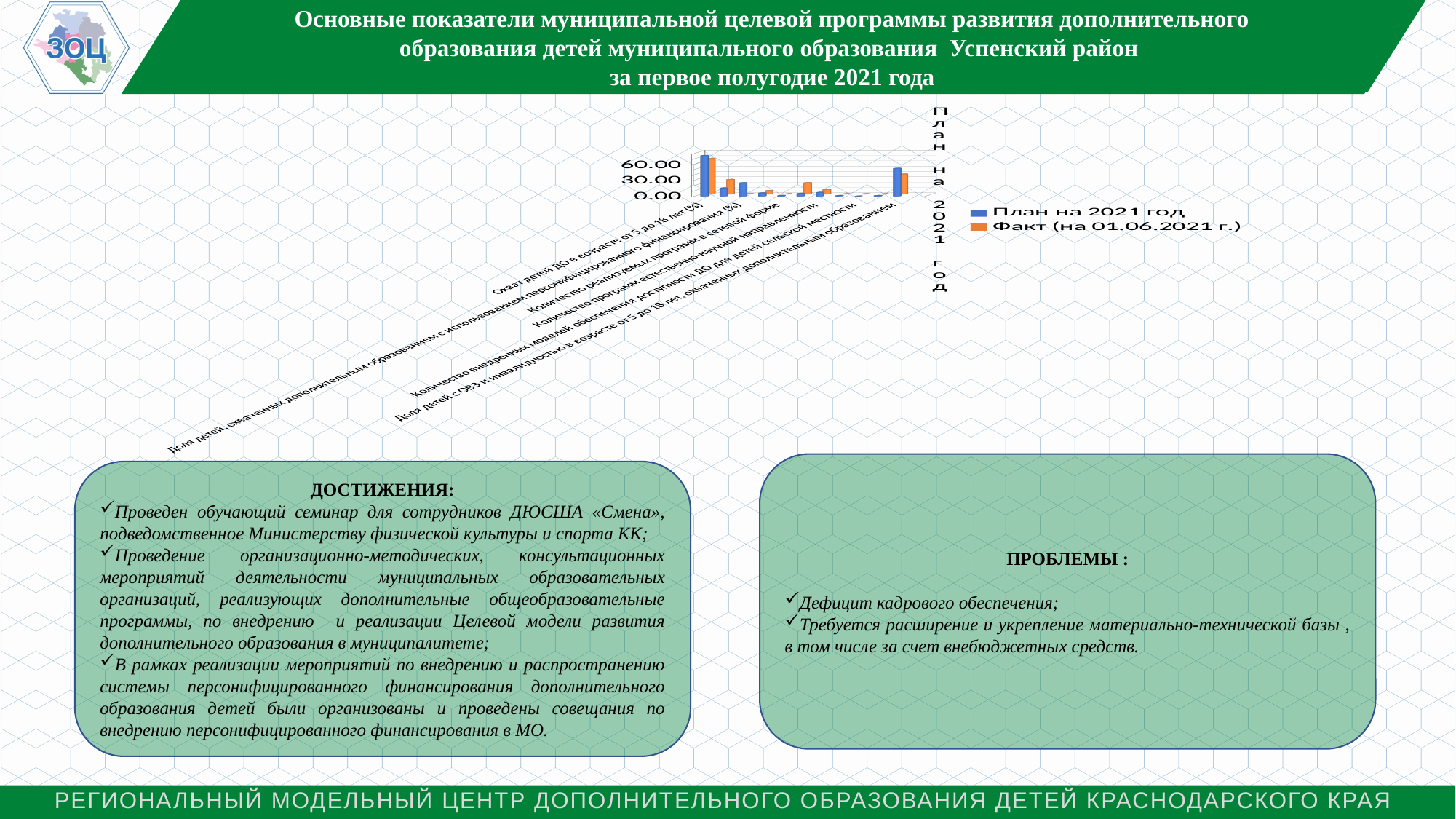
What kind of chart is shown on the slide? Bar chart How many series does the chart legend list? 2 Is the 'Факт (на 01.06.2021 г.)' value for 'Доля детей с ОВЗ и инвалидностью в возрасте от 5 до 18 лет, охваченных дополнительным образованием' greater or less than 30? greater What colour represents the series 'План на 2021 год' in the chart? Blue How many categories are plotted on the chart's x axis? 11 What colour represents the series 'Факт (на 01.06.2021 г.)' in the chart? Orange Is the 'План на 2021 год' value for 'Охват детей ДО в возрасте от 5 до 18 лет (%)' greater or less than 60? greater Is the 'План на 2021 год' value for 'Количество программ естественно-научной направленности' greater or less than 30? less Which category has the highest value for the series 'Факт (на 01.06.2021 г.)'? Охват детей ДО в возрасте от 5 до 18 лет (%) Which category has the highest value for the series 'План на 2021 год'? Охват детей ДО в возрасте от 5 до 18 лет (%)